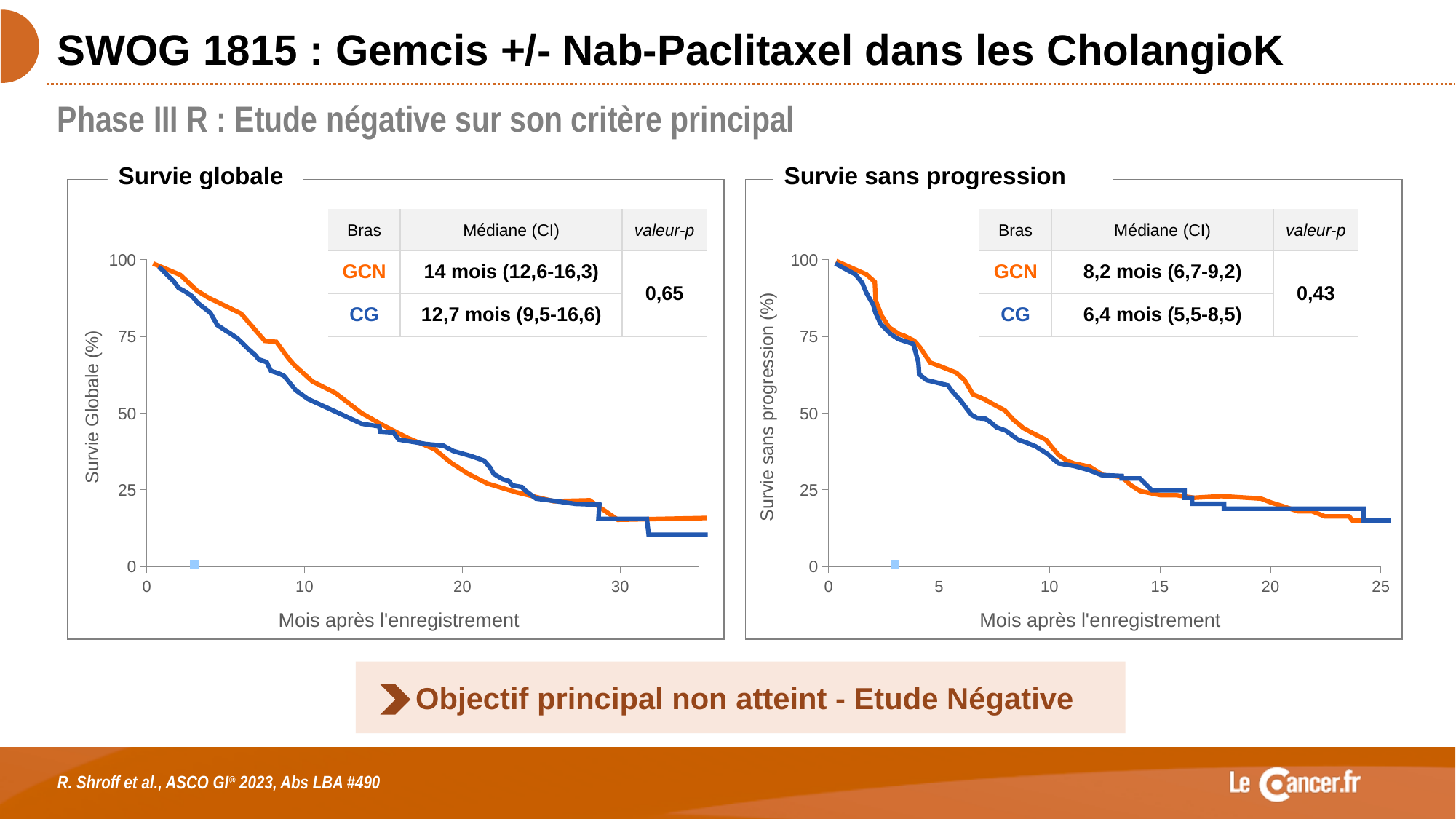
In the 'Survie globale' chart, what is the difference between the GCN and CG median survival values? 1,3 mois How many arms (series) are plotted in the 'Survie sans progression' chart? 2 In the 'Survie sans progression' chart, what is the median for the CG arm? 6,4 mois (5,5-8,5) In the 'Survie globale' chart, what is the median survival for the GCN arm? 14 mois (12,6-16,3) What kind of chart is the 'Survie globale' chart? line chart In the 'Survie sans progression' chart, what is the p-value shown? 0,43 In the 'Survie sans progression' chart, what is the median for the GCN arm? 8,2 mois (6,7-9,2) In the 'Survie globale' chart, is the GCN curve at 10 months greater or less than 50%? greater In the 'Survie globale' chart, what is the median survival for the CG arm? 12,7 mois (9,5-16,6) In the 'Survie sans progression' chart, is the CG curve at 10 months greater or less than 50%? less In the 'Survie globale' chart, what is the p-value shown? 0,65 In the 'Survie sans progression' chart, which arm has the higher median, GCN or CG? GCN